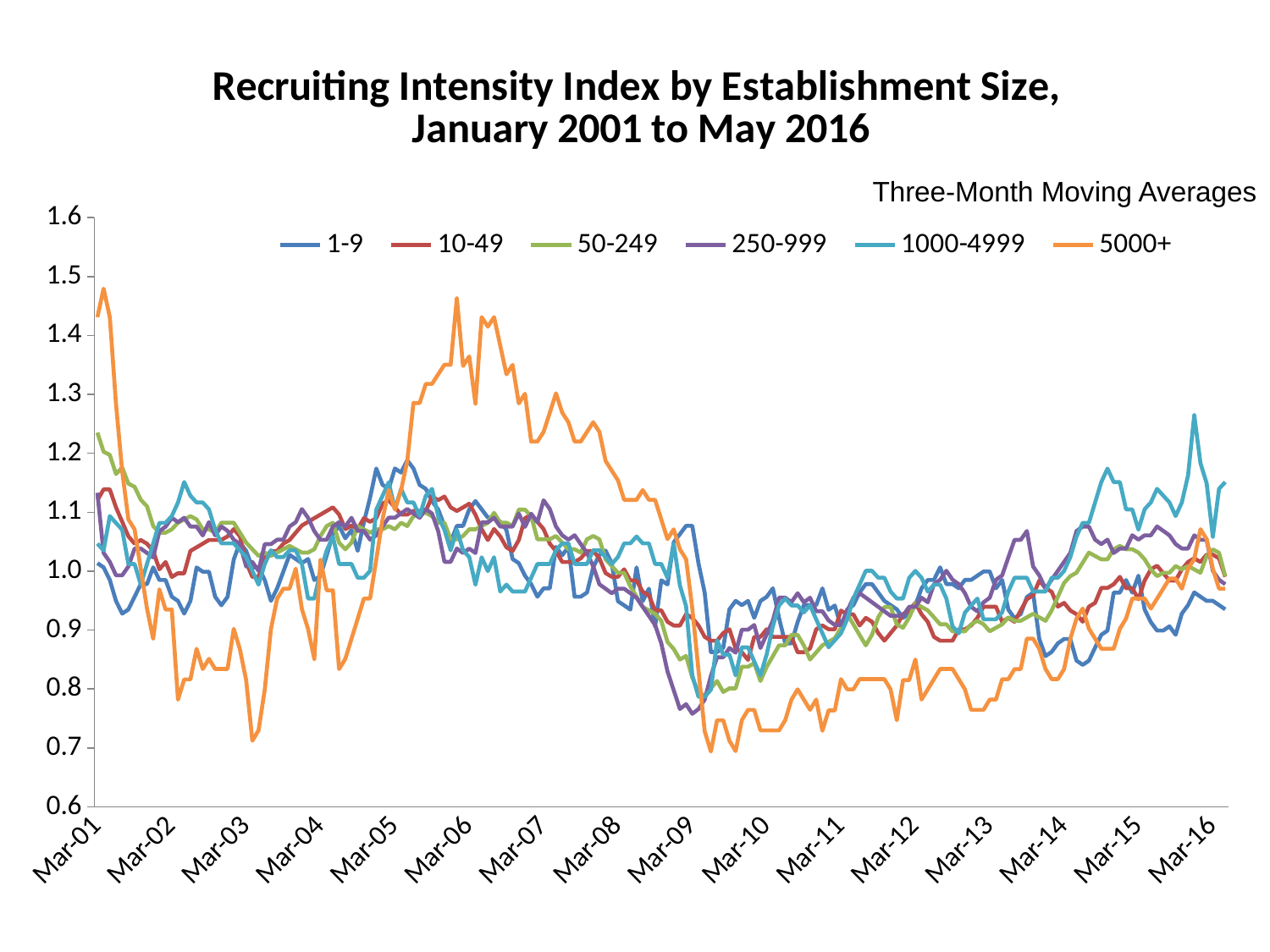
Which series reaches the highest value anywhere on the chart? 5000+ How many series does the legend list? 6 Which establishment-size series is drawn in orange? 5000+ Which series reaches the lowest value anywhere on the chart? 5000+ Is the value of the 5000+ series at Mar-10 greater or less than 0.8? less At Mar-10, which is higher: the 1-9 series or the 5000+ series? 1-9 What kind of chart is shown on the slide? line chart How many labelled tick marks are on the x axis? 16 What is the title of the chart? Recruiting Intensity Index by Establishment Size, January 2001 to May 2016 Which series is highest around Mar-07? 5000+ Is the value of the 5000+ series at Mar-01 greater or less than 1.4? greater Does the 5000+ series rise or fall between Mar-06 and Mar-09? fall